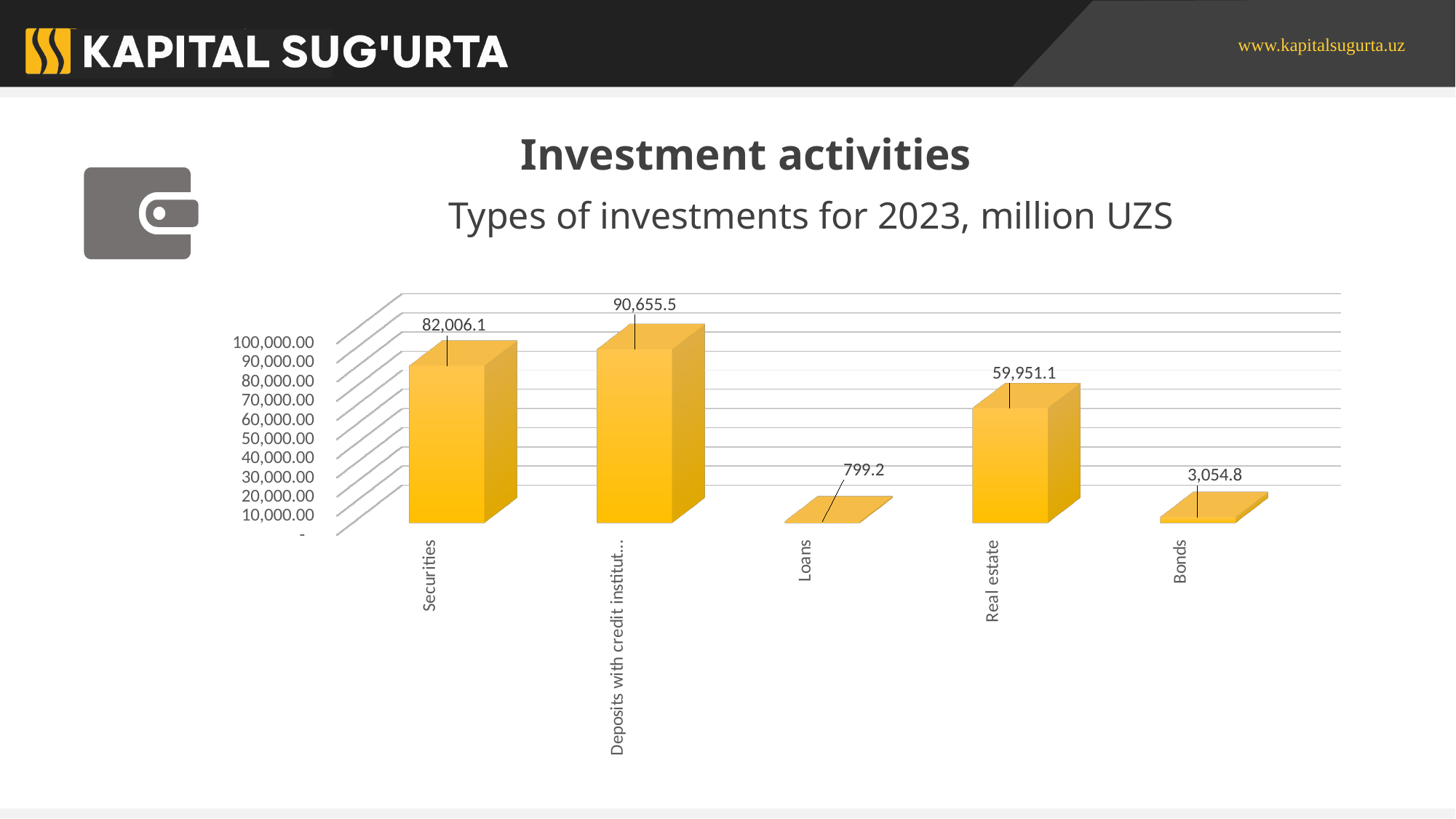
Which is larger, the value for Bonds or the value for Loans? Bonds What kind of chart is shown on the slide? Bar chart Which category has the highest value? Deposits with credit institutions Which category has the lowest value? Loans What is the value for Real estate? 59,951.1 What is the difference between the value for deposits with credit institutions and the value for Securities? 8,649.4 Is the value for Real estate greater or less than 50,000.00? greater What is the value for Bonds? 3,054.8 What is the value for Loans? 799.2 What is the value for Securities? 82,006.1 How many categories are shown in the chart? 5 What is the difference between the value for Securities and the value for Real estate? 22,055.0